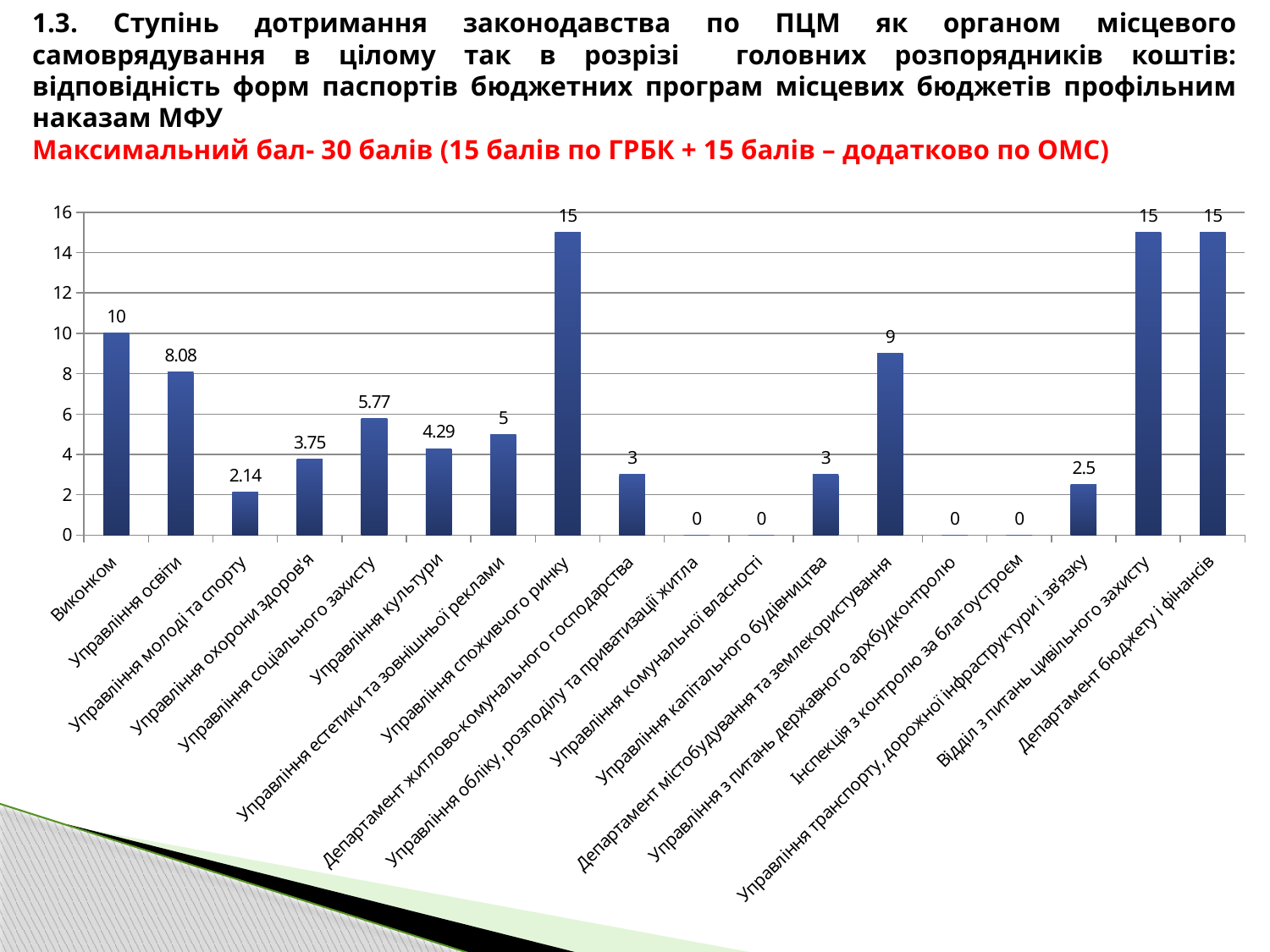
Is the value for Управління споживчого ринку greater or less than 14? greater How many categories have a value of 0? 4 What is the value for Управління соціального захисту? 5.77 What is the value for Управління освіти? 8.08 Which is larger, the value for Управління культури or the value for Управління охорони здоров'я? Управління культури What is the highest value shown in the chart? 15 What is the difference between the values for Виконком and Управління освіти? 1.92 What kind of chart is shown on the slide? bar chart What is the value for Управління транспорту, дорожньої інфраструктури і зв'язку? 2.5 What is the value for Виконком? 10 What is the value for Департамент містобудування та землекористування? 9 How many categories are shown on the x axis? 18